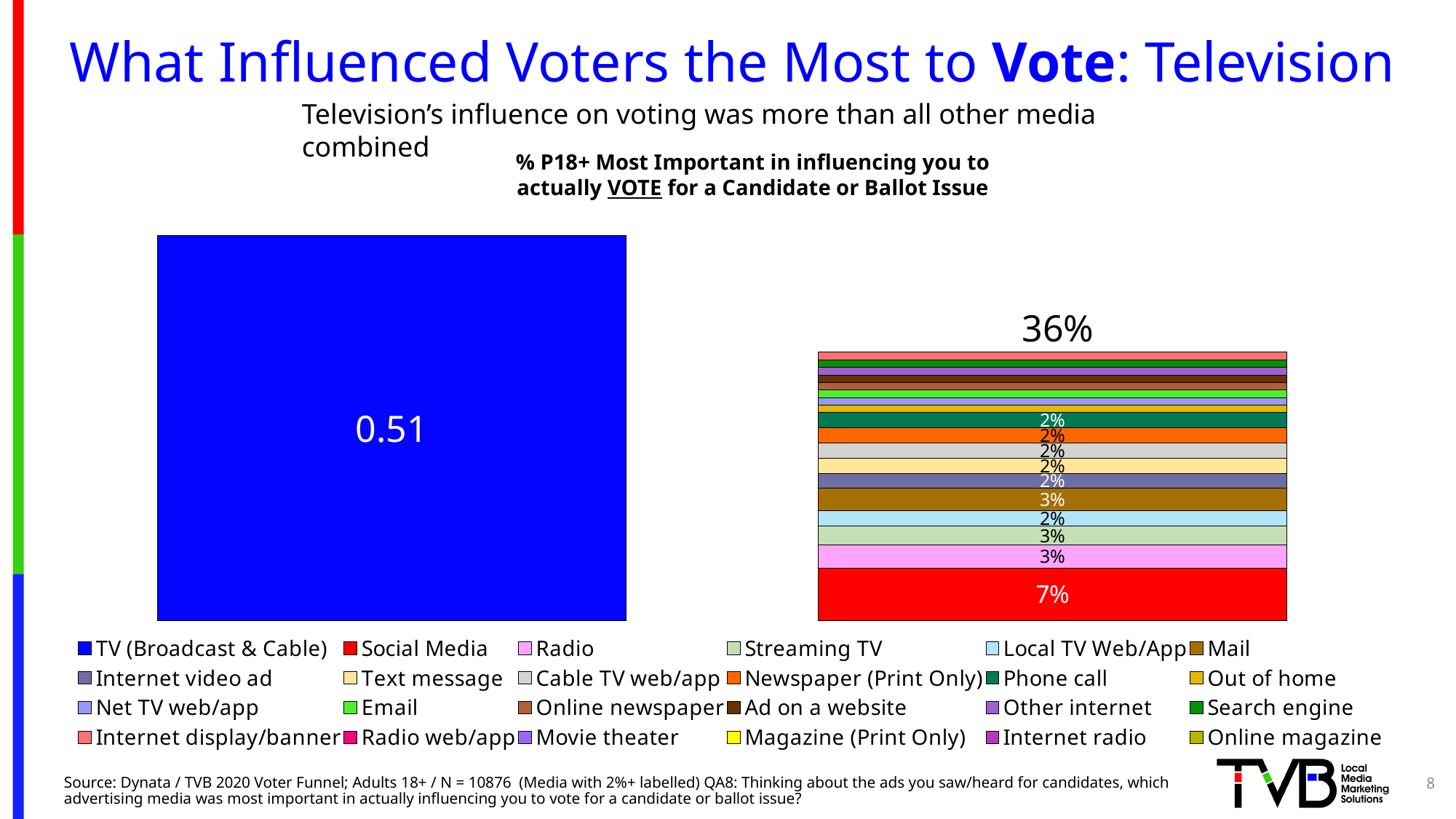
What is the total printed above the stacked bar of all other media? 36% What percentage is shown for Radio? 3% What value is printed on the TV (Broadcast & Cable) bar? 0.51 What percentage is shown for Mail? 3% How many series does the legend list? 24 What percentage is shown for Phone call? 2% What percentage is shown for Social Media? 7% What is the difference between the Social Media value and the Radio value? 4% Which labelled segment in the stacked bar of other media is the largest? Social Media Which is larger, the value for Mail or the value for Local TV Web/App? Mail What kind of chart is shown on the slide? Stacked bar chart What is the title printed above the chart? % P18+ Most Important in influencing you to actually VOTE for a Candidate or Ballot Issue